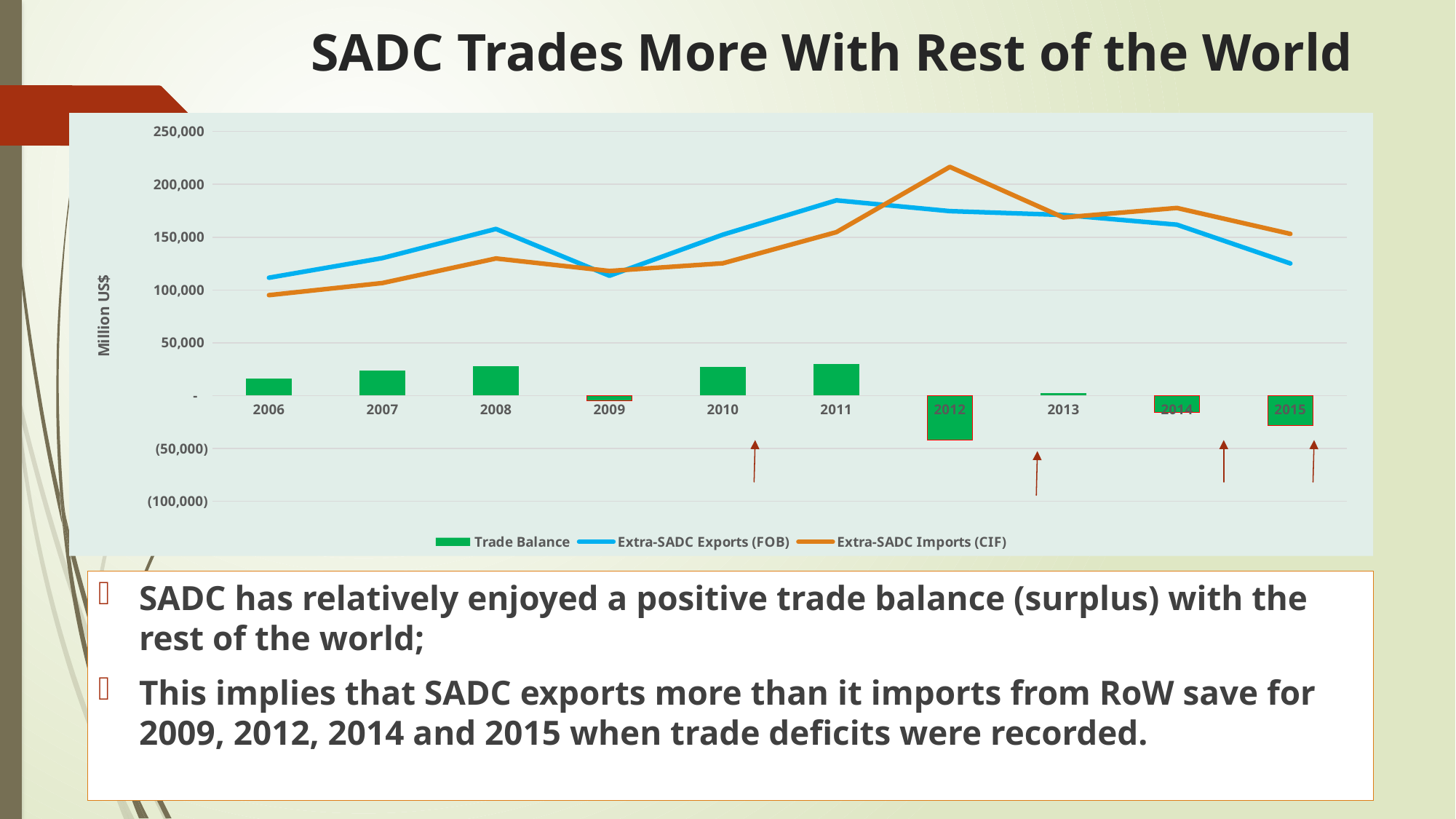
In which year do Extra-SADC Exports (FOB) reach their highest value? 2011 In which year are Extra-SADC Imports (CIF) at their lowest? 2006 What unit is shown on the chart's vertical axis label? Million US$ In 2008, which is larger: Extra-SADC Exports (FOB) or Extra-SADC Imports (CIF)? Extra-SADC Exports (FOB) Is the value of Extra-SADC Imports (CIF) in 2012 greater or less than 200,000? greater How many years are shown along the x axis of the chart? 10 In which year is the Trade Balance at its lowest (largest deficit)? 2012 In which year do Extra-SADC Imports (CIF) reach their highest value? 2012 Is the value of Extra-SADC Exports (FOB) in 2009 greater or less than 150,000? less Do Extra-SADC Exports (FOB) rise or fall from 2011 to 2015? Fall How many series does the chart legend list? 3 What kind of chart is shown on the slide? Combined bar and line chart